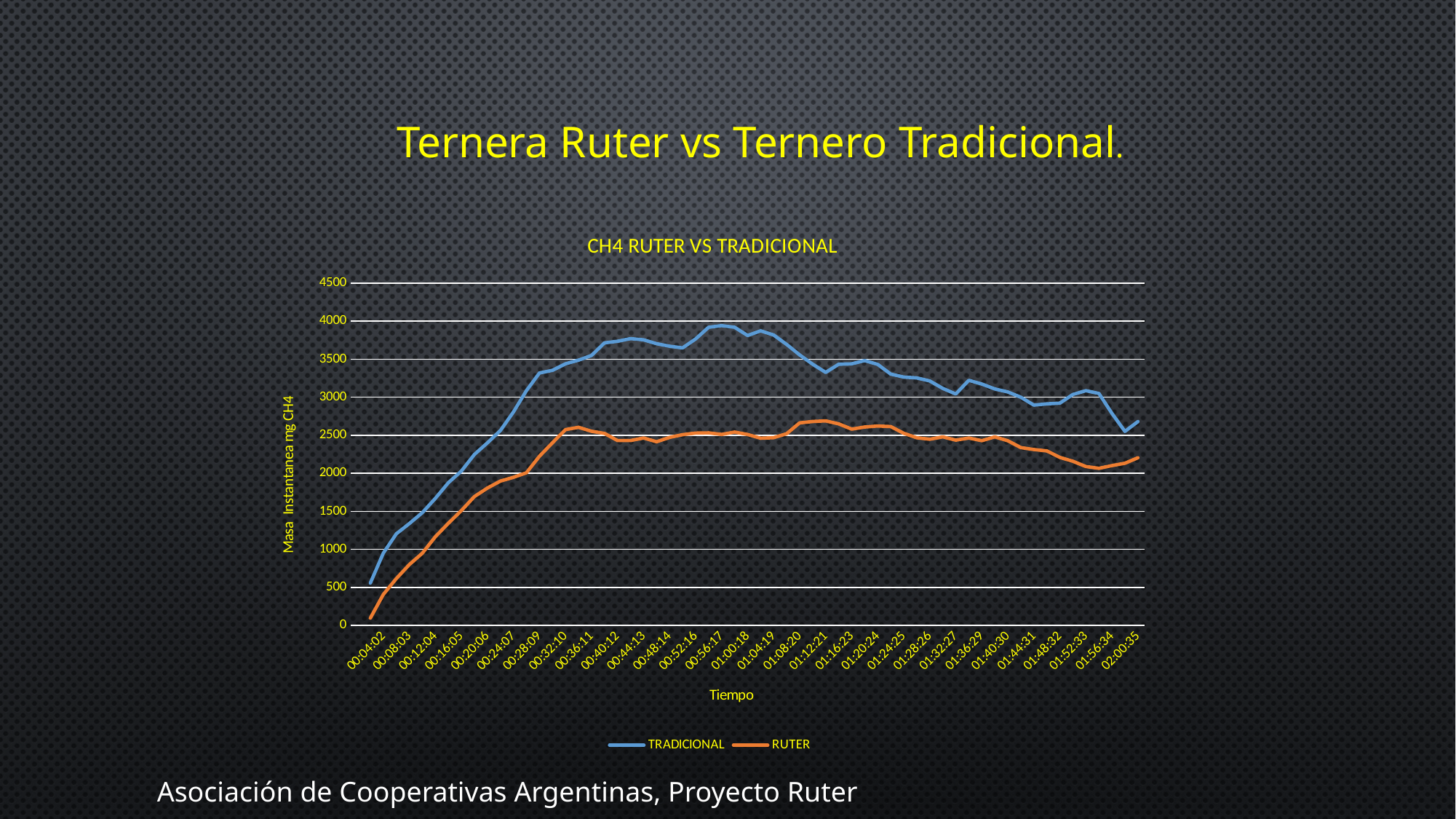
Is the value for RUTER at 00:04:02 greater or less than 500? less What is the label of the x axis? Tiempo Which series reaches the highest value anywhere on the chart? TRADICIONAL Which series is drawn in orange? RUTER Does the TRADICIONAL series rise or fall between 00:04:02 and 00:28:09? rise What kind of chart is shown on the slide? line chart Is the value for TRADICIONAL at 00:56:17 greater or less than 3500? greater At 00:56:17, which series has the higher value, TRADICIONAL or RUTER? TRADICIONAL Is the value for RUTER at 01:08:20 greater or less than 3000? less How many series does the legend list? 2 What is the title of the chart? CH4 RUTER VS TRADICIONAL